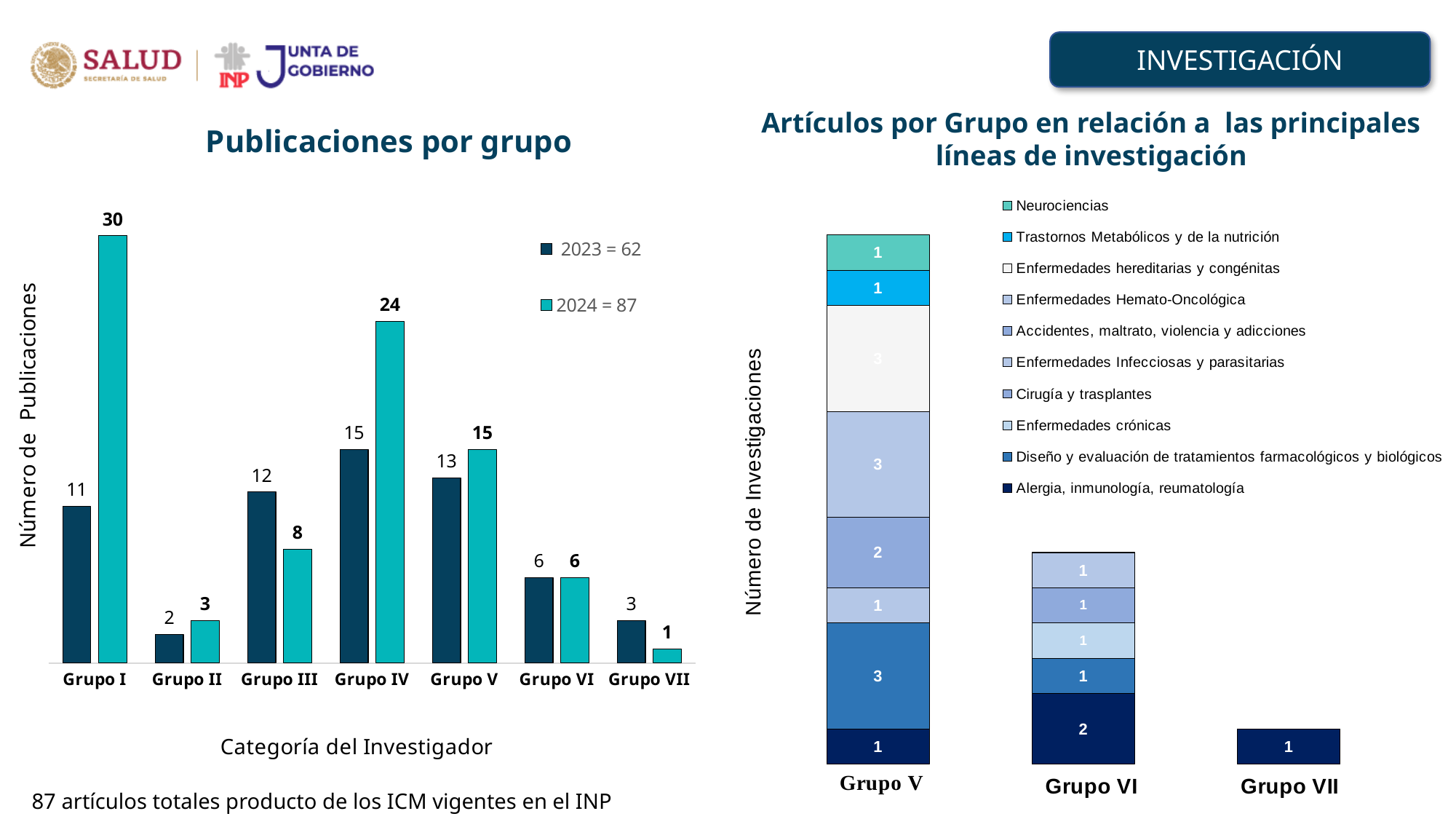
What kind of chart is the 'Publicaciones por grupo' chart? bar chart In the 'Artículos por Grupo' chart on the right, what is the total of the stacked bar for Grupo VI? 6 In the 'Publicaciones por grupo' chart, which group has the highest 2024 value? Grupo I In the 'Publicaciones por grupo' chart, what is the 2023 value for Grupo III? 12 In the 'Publicaciones por grupo' chart, what is the 2024 value for Grupo I? 30 How many entries does the legend of the 'Artículos por Grupo' chart on the right list? 10 In the 'Publicaciones por grupo' chart, which is larger for Grupo III: the 2023 value or the 2024 value? 2023 In the 'Publicaciones por grupo' chart, what is the difference between the 2024 and 2023 values for Grupo IV? 9 How many groups are shown on the x axis of the 'Publicaciones por grupo' chart? 7 In the 'Publicaciones por grupo' chart, which group has the lowest 2023 value? Grupo II In the 'Artículos por Grupo' chart on the right, what is the value of the 'Alergia, inmunología, reumatología' segment for Grupo VI? 2 How many series does the legend of the 'Publicaciones por grupo' chart list? 2